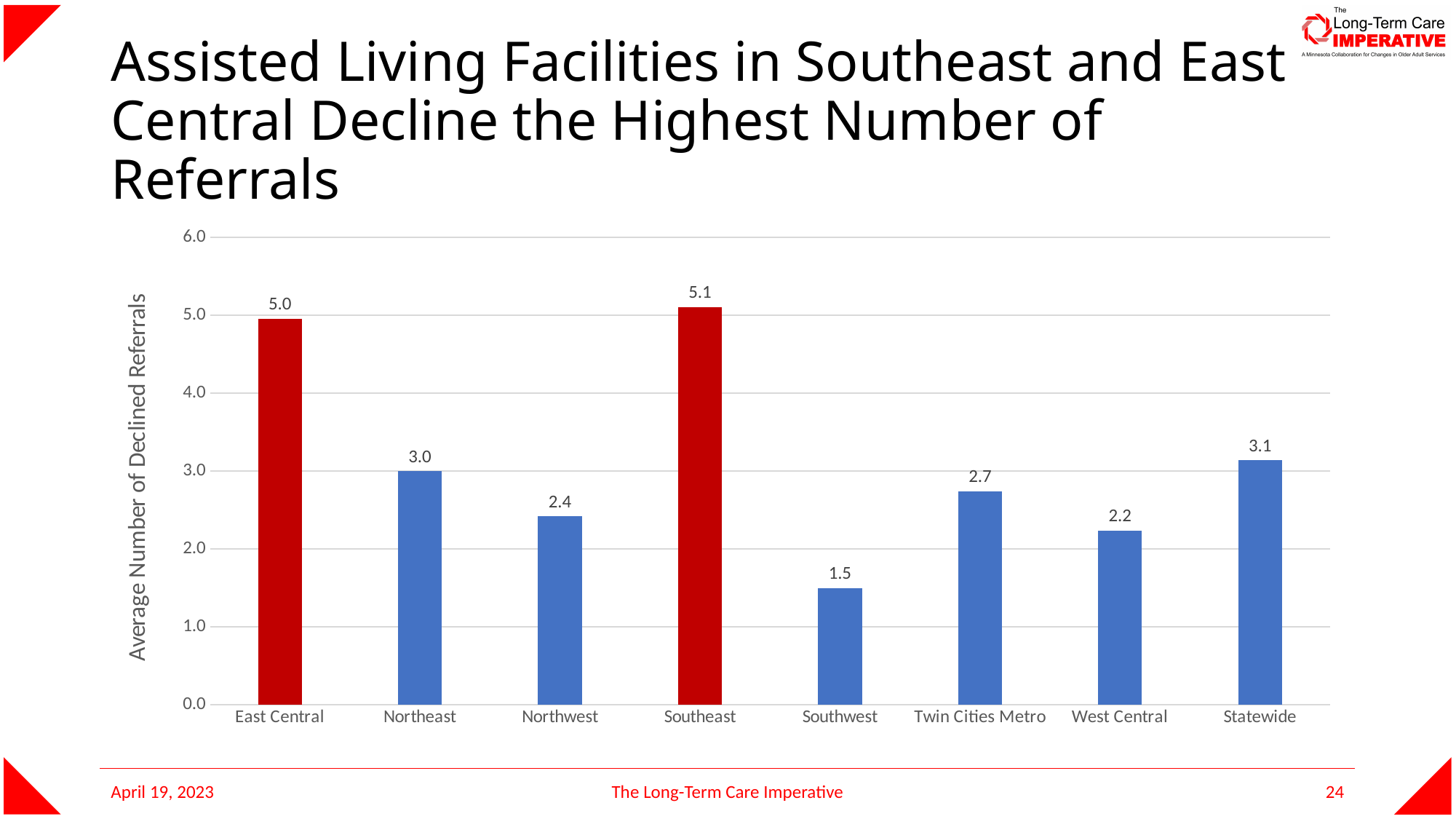
Which region has the lowest average number of declined referrals? Southwest What is the average number of declined referrals for Southwest? 1.5 Which has a higher average number of declined referrals, Northeast or Twin Cities Metro? Northeast Which two bars are coloured red? East Central and Southeast What is the Statewide average number of declined referrals? 3.1 What kind of chart is shown on the slide? bar chart What is the average number of declined referrals for East Central? 5.0 What is the label of the vertical axis? Average Number of Declined Referrals What is the difference between the Southeast and Southwest values? 3.6 Is the value for West Central greater or less than 3.0? less Which region has the highest average number of declined referrals? Southeast How many categories are shown on the x axis? 8